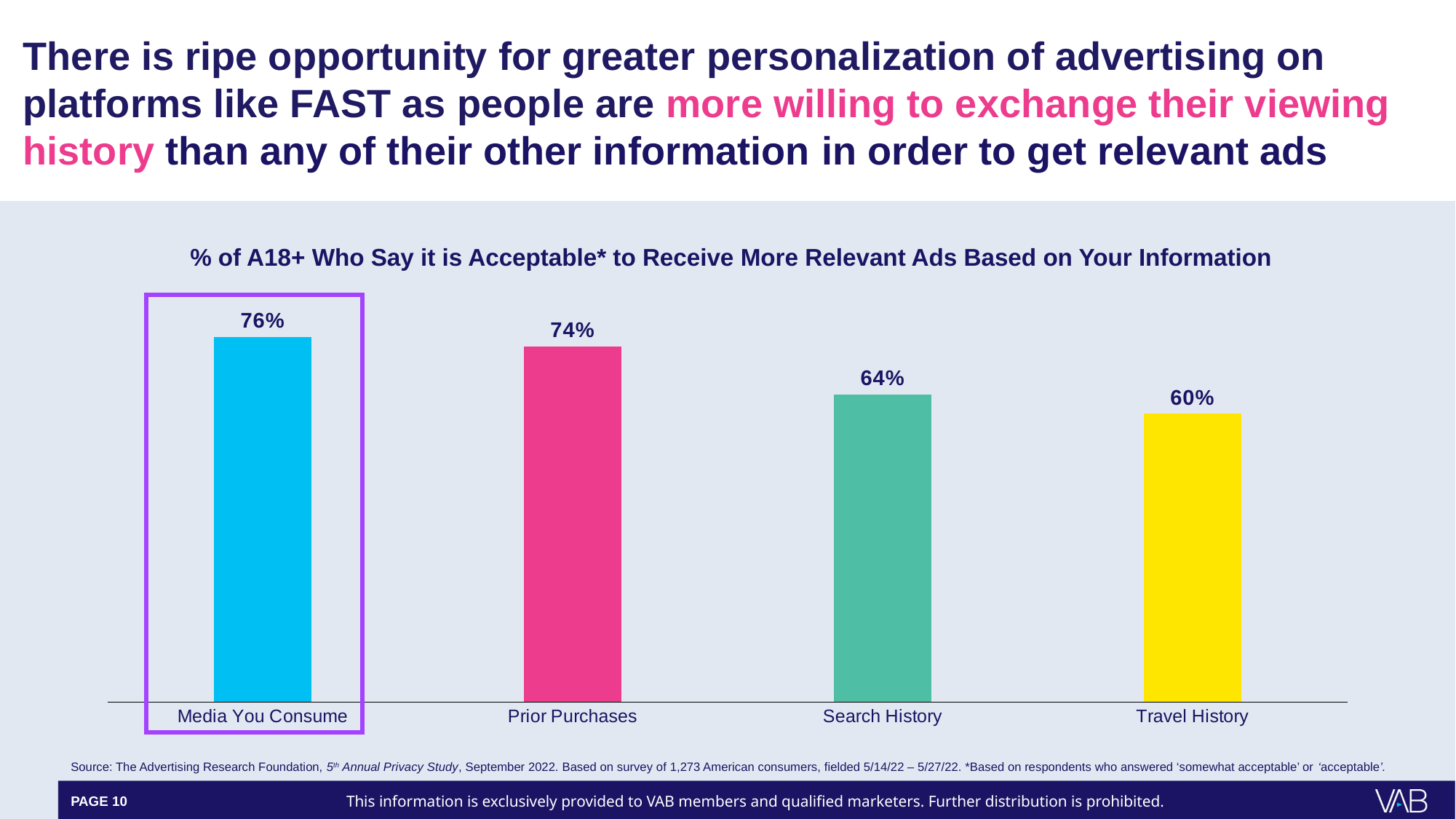
What is the value shown for Search History? 64% What is the difference in percentage points between Prior Purchases and Search History? 10 What percentage of A18+ say it is acceptable to receive more relevant ads based on Media You Consume? 76% What kind of chart is shown on the slide? Bar chart How many categories are shown in the chart? 4 Which category has the highest percentage? Media You Consume Which category has the lowest percentage? Travel History Which is larger, the value for Search History or the value for Travel History? Search History What is the difference in percentage points between Media You Consume and Travel History? 16 What is the value shown for Prior Purchases? 74% What is the value shown for Travel History? 60% Which category's bar is outlined with a purple box? Media You Consume